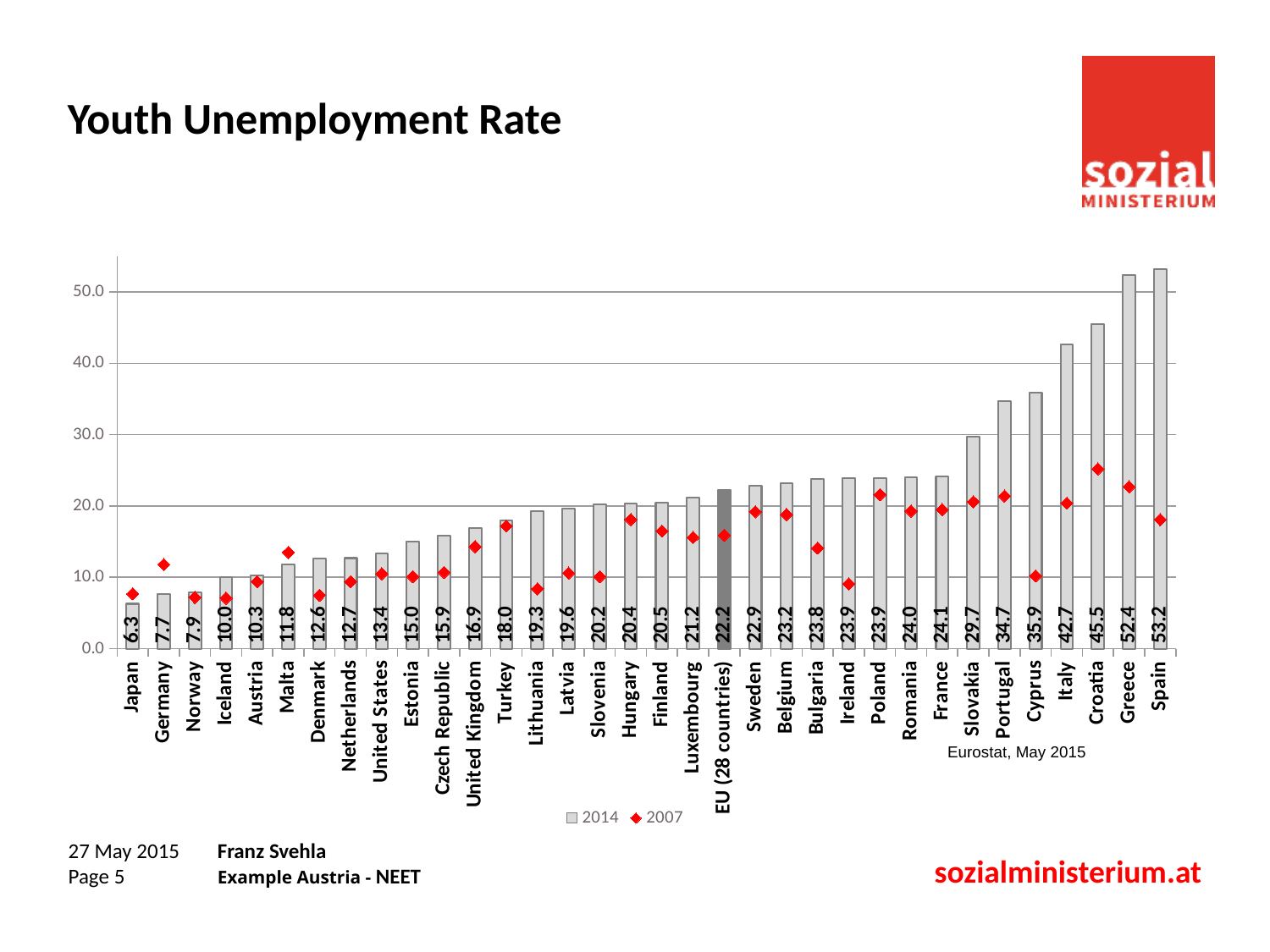
What is the 2014 value shown for EU (28 countries)? 22.2 How many countries or regions are shown on the x axis? 34 What is the difference between the 2014 values for Spain and Greece? 0.8 What is the 2014 youth unemployment rate shown for Austria? 10.3 Is the 2007 value for Malta greater or less than 10.0? greater How many series does the legend list? 2 What is the 2014 value shown for Greece? 52.4 Which country has the lowest 2014 youth unemployment rate? Japan Is the 2007 value for Croatia greater or less than 20.0? greater Do the 2014 values rise or fall from left to right along the x axis? rise Which has a higher 2014 value, Italy or Portugal? Italy Which country has the highest 2014 youth unemployment rate? Spain